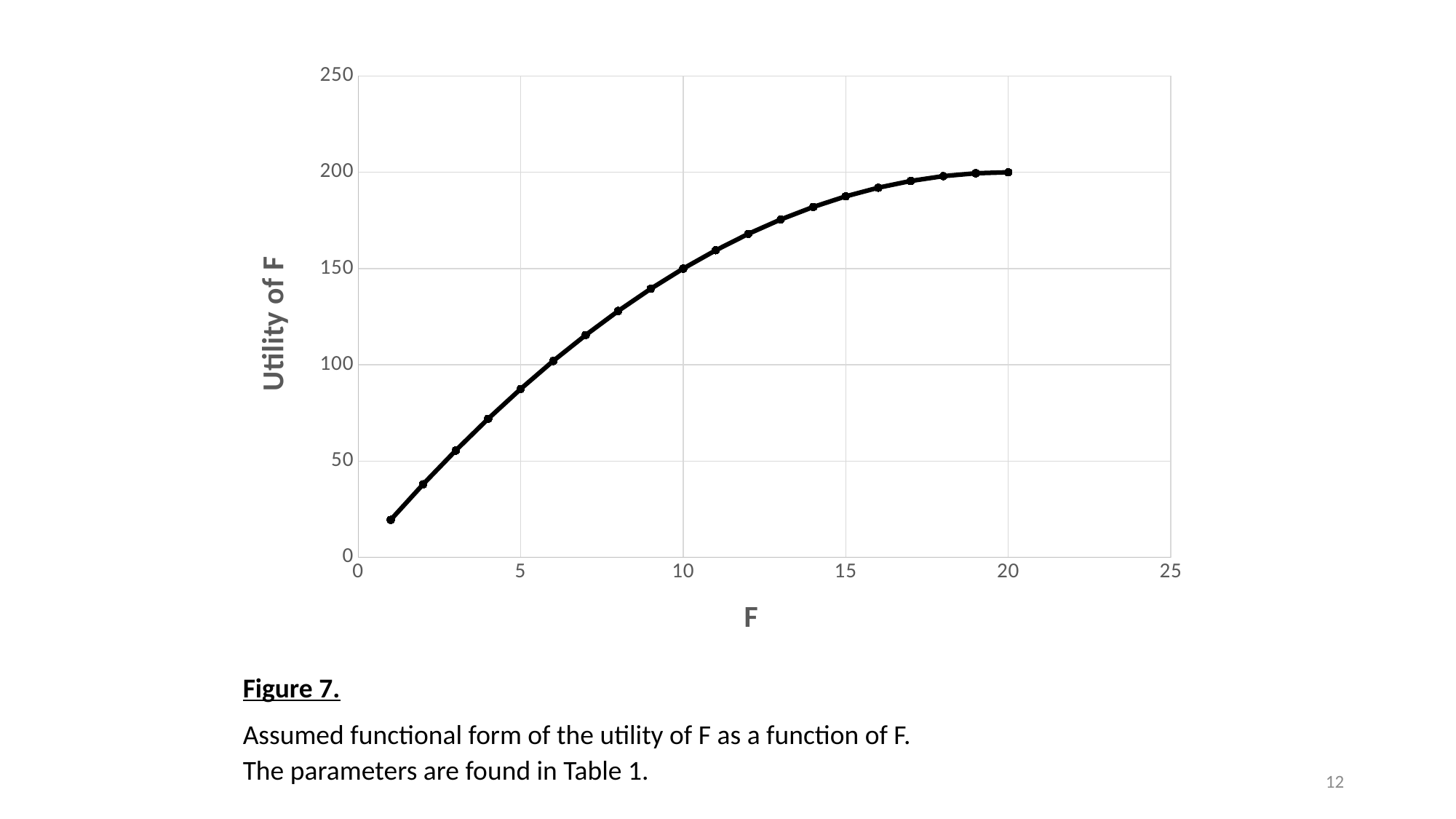
At which value of F is the utility of F lowest? 1 Is the utility of F at F = 15 greater or less than 150? greater At which value of F is the utility of F highest? 20 Does the utility of F rise or fall as F increases along the x axis? rise Which is larger, the utility of F at F = 15 or at F = 5? F = 15 Is the utility of F at F = 1 greater or less than 50? less How many data points are plotted on the curve? 20 What is the utility of F when F is 10? 150 What kind of chart is shown on the slide? line chart What is the utility of F when F is 20? 200 What is the title of the vertical axis? Utility of F Is the utility of F at F = 5 greater or less than 100? less